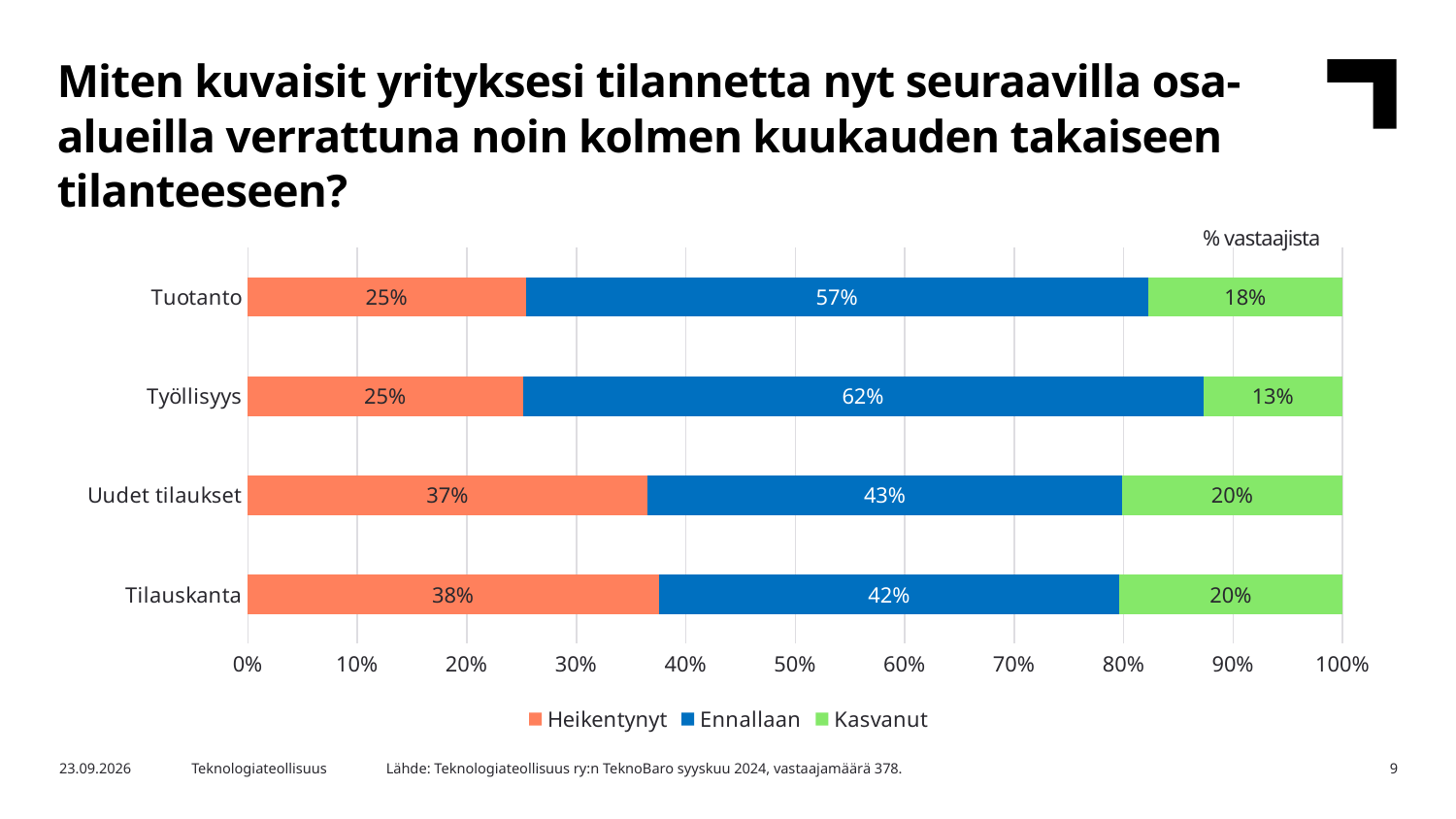
What is the Heikentynyt value for Tilauskanta? 38% Which series is shown in green in the legend? Kasvanut What kind of chart is shown on the slide? Stacked bar chart How many series does the legend list? 3 Which category has the lowest Kasvanut value? Työllisyys How many categories are shown on the chart? 4 What is the Ennallaan value for Tuotanto? 57% Which category has the highest Ennallaan value? Työllisyys What is the total of the stacked bar for Uudet tilaukset? 100% What is the Kasvanut value for Työllisyys? 13% What is the difference between the Ennallaan values for Työllisyys and Tilauskanta? 20% Which is larger: the Heikentynyt value for Uudet tilaukset or the Heikentynyt value for Tuotanto? Uudet tilaukset